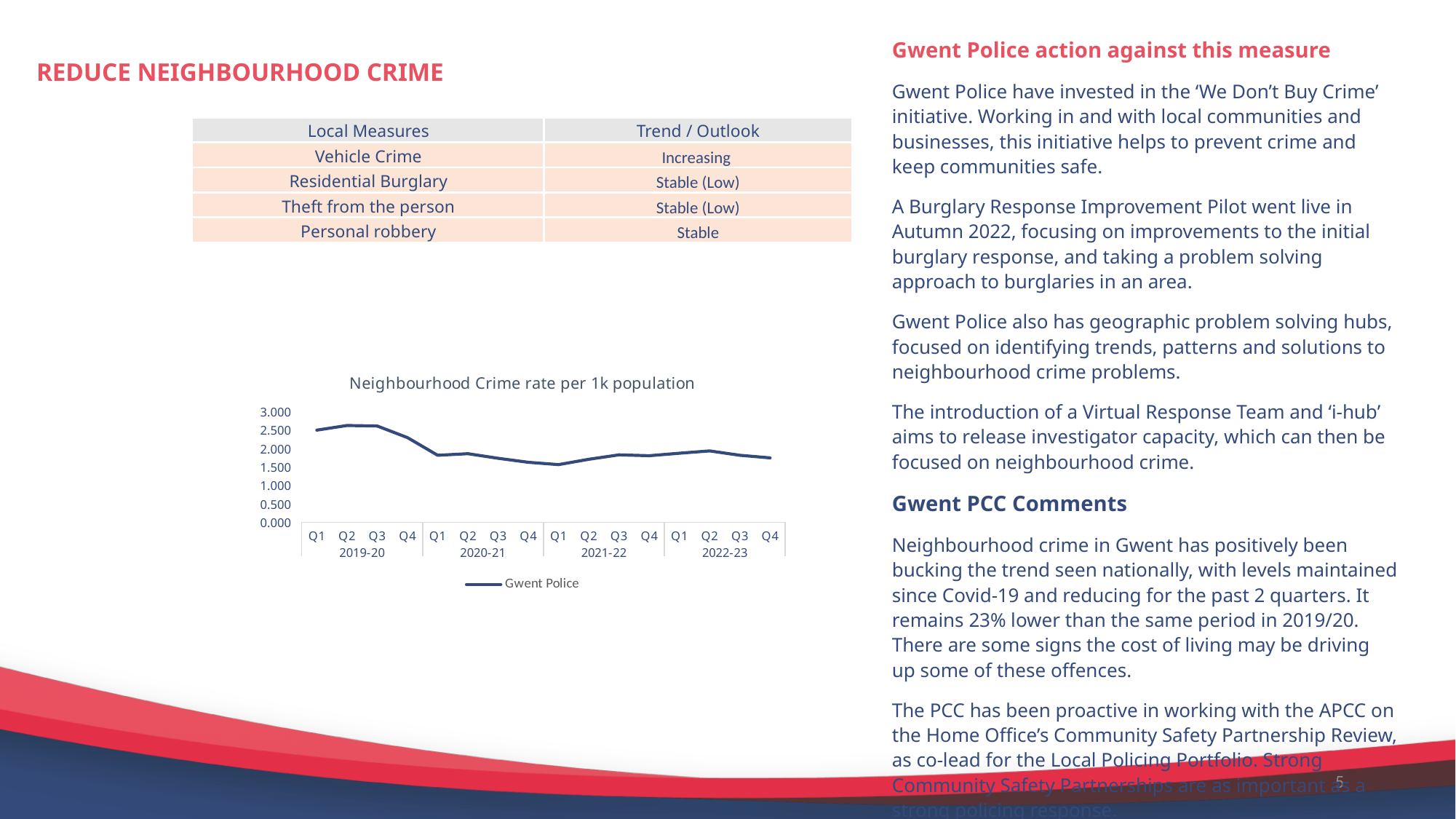
Which is larger, the value for Q3 2019-20 or the value for Q4 2020-21? Q3 2019-20 Is the value for Q1 2020-21 greater or less than 2.500? less Is the value for Q1 2019-20 greater or less than 2.000? greater Is the value for Q1 2021-22 greater or less than 2.000? less What is the name of the series shown in the chart's legend? Gwent Police How many quarterly data points are plotted on the chart? 16 How many series does the chart's legend list? 1 What is the title of the chart on the slide? Neighbourhood Crime rate per 1k population Which is larger, the value for Q1 2019-20 or the value for Q1 2021-22? Q1 2019-20 What kind of chart is shown on the slide? line chart Overall, does the crime rate rise or fall from Q1 2019-20 to Q4 2022-23? fall